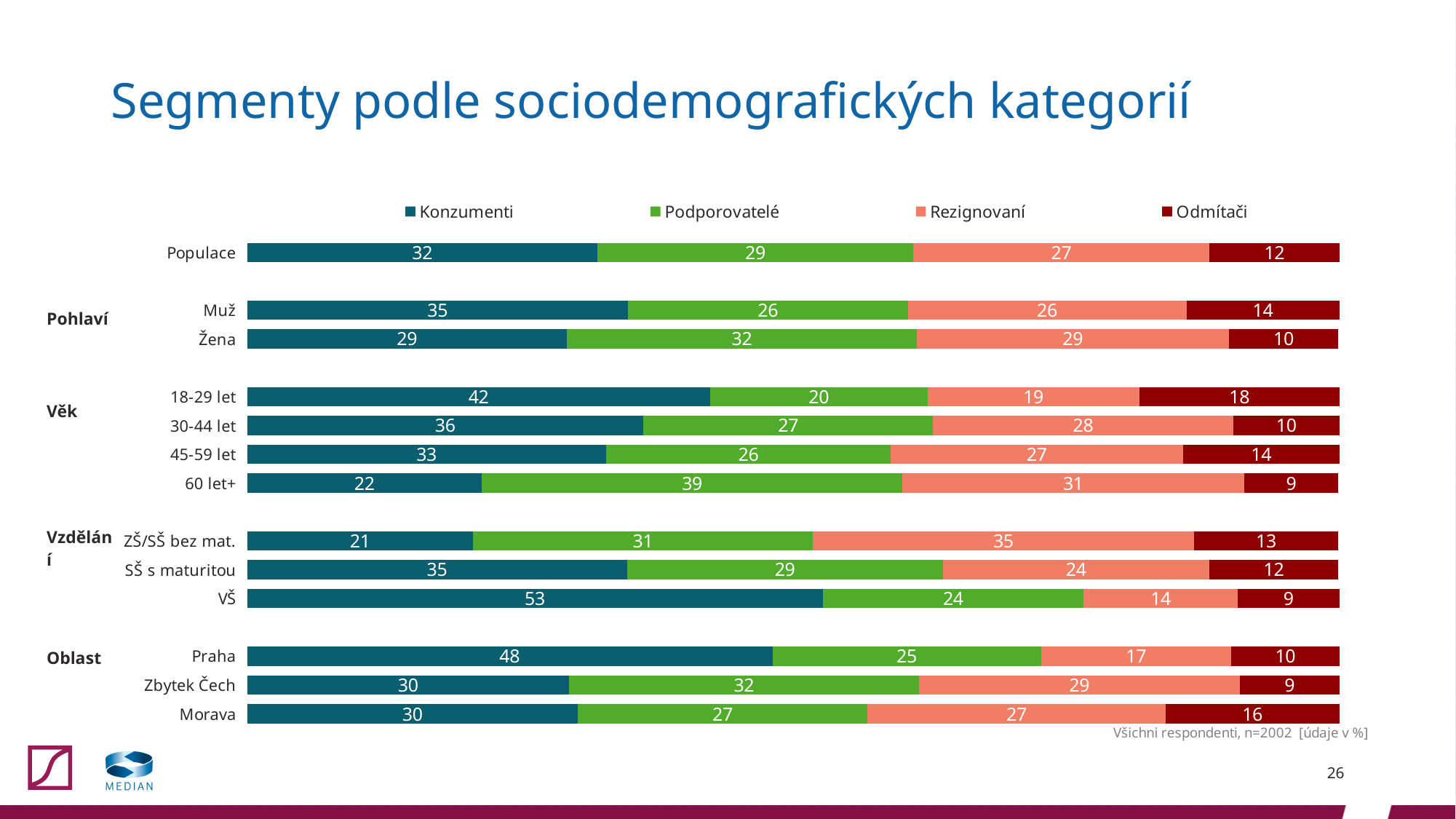
Which category has the highest Konzumenti value? VŠ Which category has the lowest Konzumenti value? ZŠ/SŠ bez mat. What is the Konzumenti value for VŠ? 53 What is the total of the stacked bar for Praha? 100 What is the difference between the Konzumenti values for Muž and Žena? 6 What is the Rezignovaní value for ZŠ/SŠ bez mat.? 35 What type of chart is shown on the slide? stacked bar chart What is the Odmítači value for Morava? 16 How many categories (bars) are plotted in the chart? 13 How many series does the legend list? 4 Which is larger, the Odmítači value for 18-29 let or for 30-44 let? 18-29 let What is the Podporovatelé value for 60 let+? 39